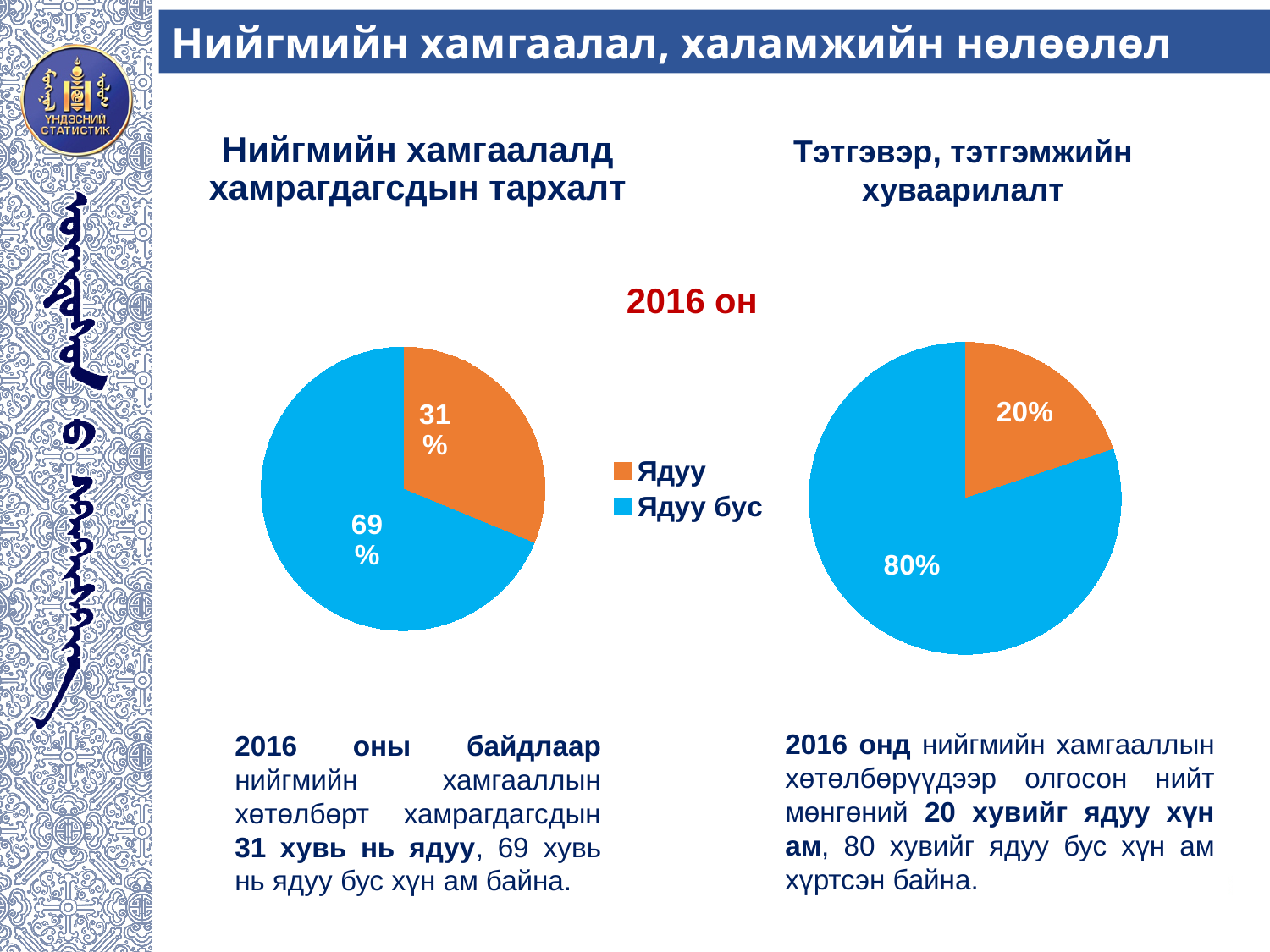
In the right pie chart (Тэтгэвэр, тэтгэмжийн хуваарилалт), what share is labelled for the Ядуу slice? 20% In the left pie chart (Нийгмийн хамгаалалд хамрагдагсдын тархалт), what share is labelled for the Ядуу бус slice? 69% What type of chart is used on this slide? Pie chart In the right pie chart (Тэтгэвэр, тэтгэмжийн хуваарилалт), which category has the smallest slice? Ядуу In the right pie chart (Тэтгэвэр, тэтгэмжийн хуваарилалт), what is the difference in percentage points between the Ядуу бус and Ядуу slices? 60 In the right pie chart (Тэтгэвэр, тэтгэмжийн хуваарилалт), what share is labelled for the Ядуу бус slice? 80% In the left pie chart (Нийгмийн хамгаалалд хамрагдагсдын тархалт), what share is labelled for the Ядуу slice? 31% Is the Ядуу share larger in the left pie chart (Нийгмийн хамгаалалд хамрагдагсдын тархалт) or in the right pie chart (Тэтгэвэр, тэтгэмжийн хуваарилалт)? Left pie chart In the left pie chart (Нийгмийн хамгаалалд хамрагдагсдын тархалт), what is the difference in percentage points between the Ядуу бус and Ядуу slices? 38 How many slices does the left pie chart (Нийгмийн хамгаалалд хамрагдагсдын тархалт) have? 2 How many entries does the legend between the two pie charts list? 2 In the left pie chart (Нийгмийн хамгаалалд хамрагдагсдын тархалт), which category has the largest slice? Ядуу бус